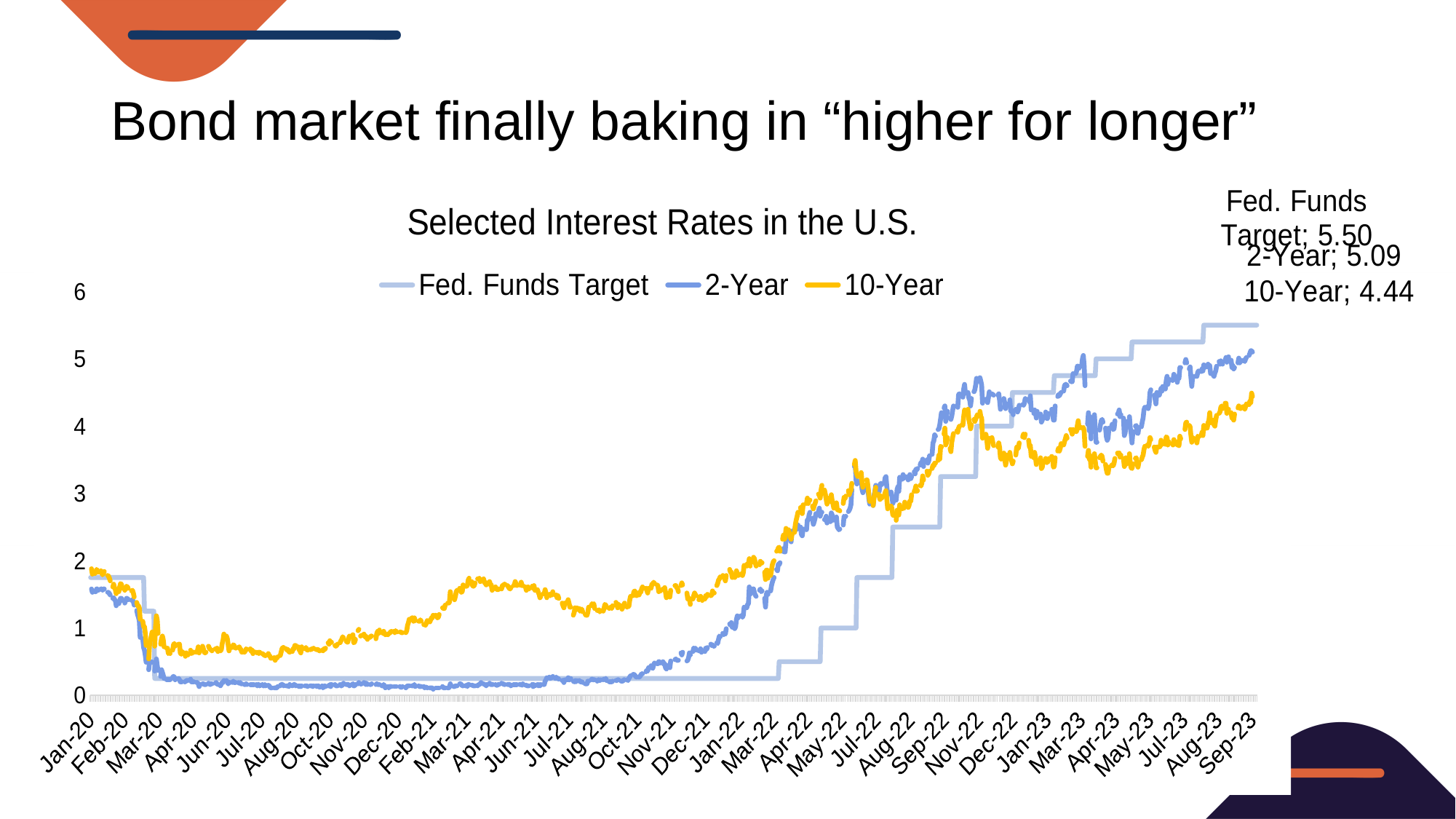
Which series has the lowest labelled end value? 10-Year Is the 10-Year value in Jul-21 greater or less than 2? less What is the final labelled value of the Fed. Funds Target series? 5.50 What is the final labelled value of the 2-Year series? 5.09 What kind of chart is shown on the slide? Line chart What is the difference between the labelled end values of the 2-Year and the 10-Year series? 0.65 What is the difference between the labelled end values of the Fed. Funds Target and the 10-Year series? 1.06 Does the Fed. Funds Target series rise or fall from Jan-22 to Sep-23? Rise How many series does the legend list? 3 What is the final labelled value of the 10-Year series? 4.44 At the end of the chart, which is larger: the 2-Year value or the 10-Year value? 2-Year Which series has the highest labelled end value? Fed. Funds Target